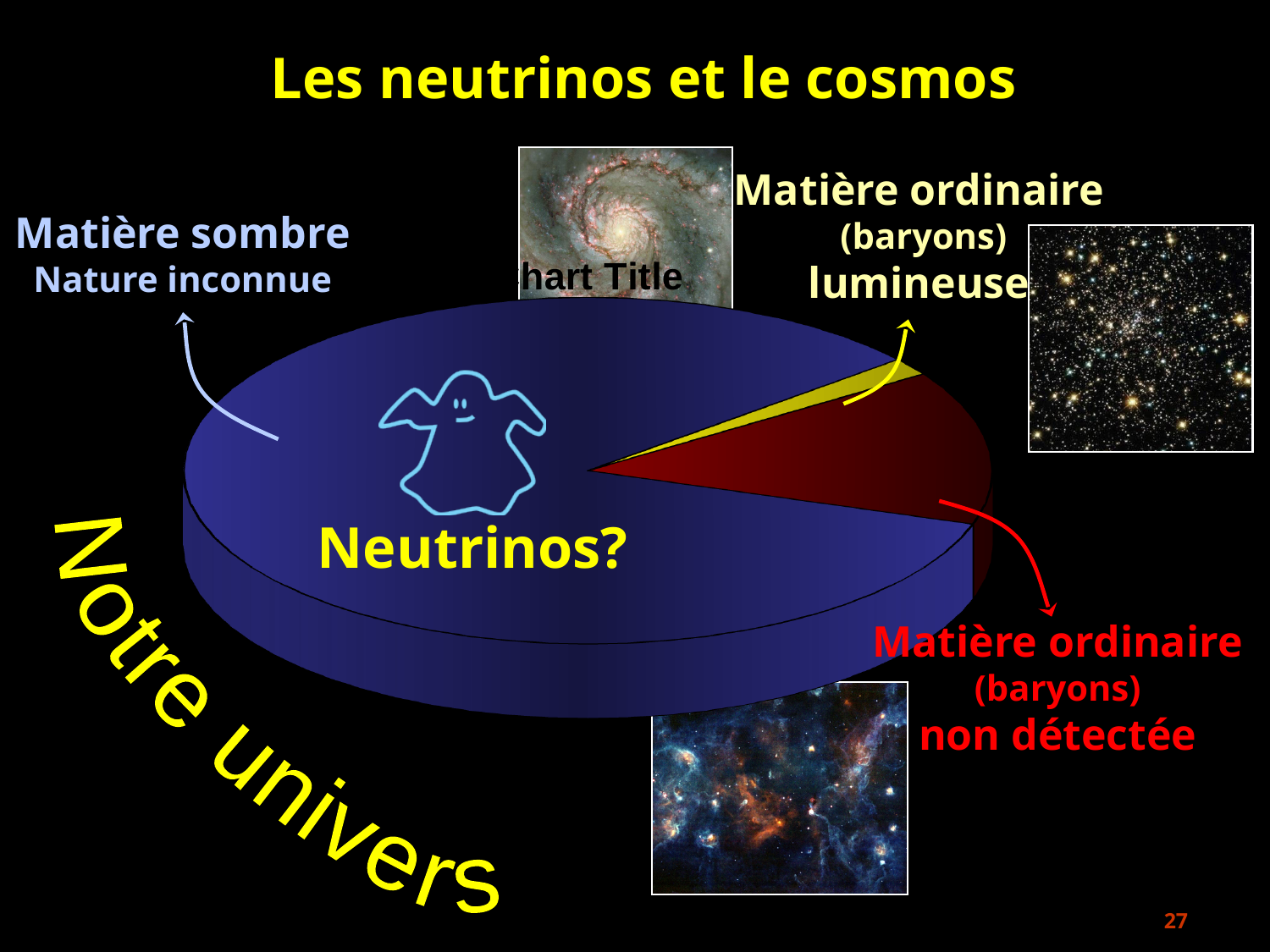
Which slice of the pie chart is the smallest? Matière ordinaire (baryons) lumineuse How many slices does the pie chart have? 3 What kind of chart is shown on the slide? pie chart Which slice is larger: Matière sombre or Matière ordinaire non détectée? Matière sombre Which slice of the pie chart is the largest? Matière sombre What colour is the slice labelled Matière sombre? blue Which slice is larger: Matière ordinaire non détectée or Matière ordinaire lumineuse? Matière ordinaire non détectée What colour is the slice labelled Matière ordinaire (baryons) non détectée? red